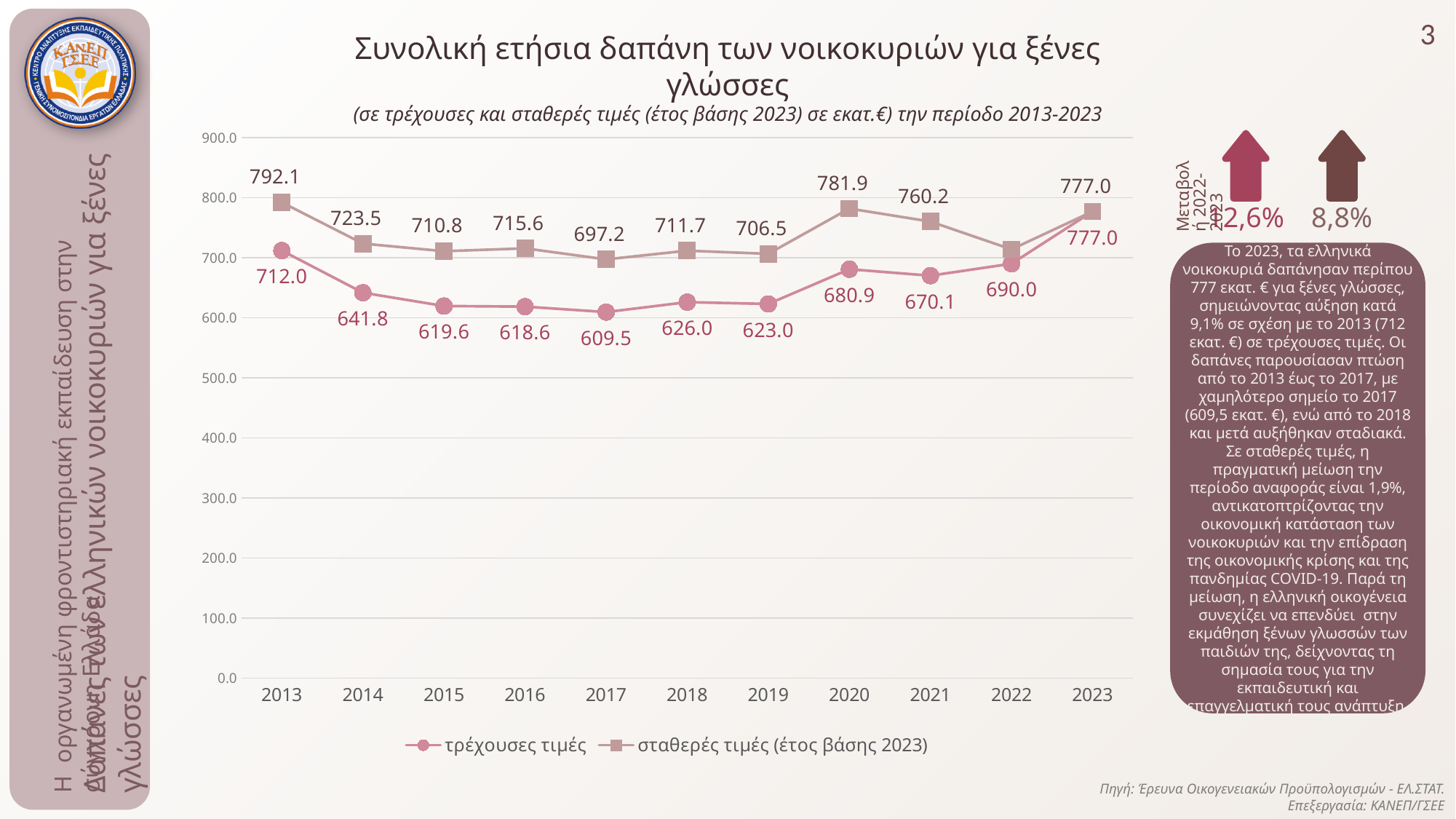
How many years are shown on the x axis? 11 What is the value for σταθερές τιμές (έτος βάσης 2023) in 2013? 792.1 What is the difference between the τρέχουσες τιμές values for 2023 and 2013? 65.0 How many series does the legend list? 2 What kind of chart is shown on the slide? line chart Which year has the larger τρέχουσες τιμές value, 2020 or 2021? 2020 What is the difference between the σταθερές τιμές values for 2020 and 2021? 21.7 In which year is the τρέχουσες τιμές series at its lowest? 2017 In which year is the σταθερές τιμές (έτος βάσης 2023) series at its highest? 2013 What is the value for τρέχουσες τιμές in 2017? 609.5 What is the value for τρέχουσες τιμές in 2014? 641.8 In which year is the τρέχουσες τιμές series at its highest? 2023